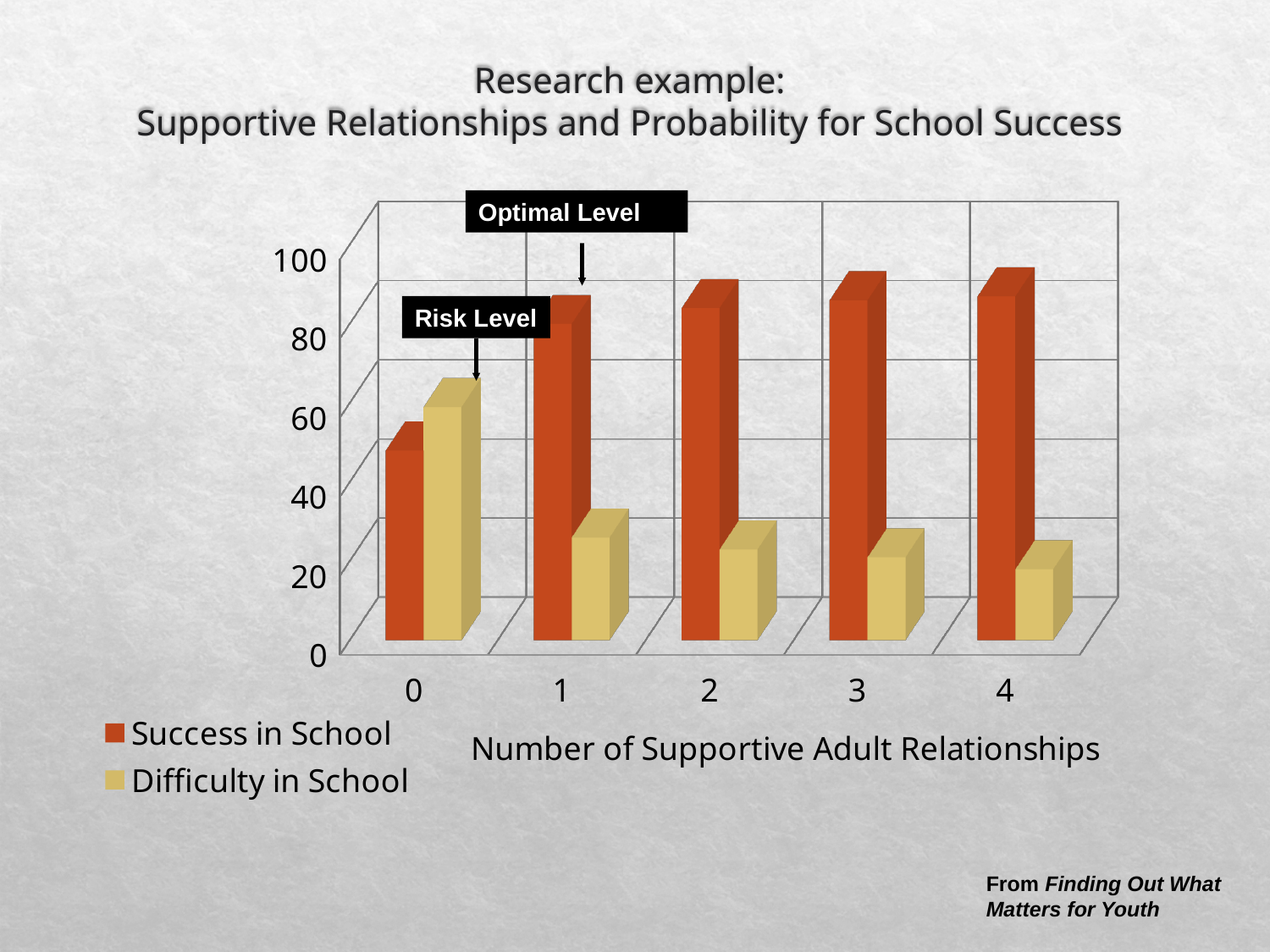
What kind of chart is shown on the slide? bar chart Is the value for Success in School at 0 supportive adult relationships greater or less than 60? less How many categories are shown along the x axis? 5 Which category has the lowest value for Success in School? 0 At 0 supportive adult relationships, which is larger: Success in School or Difficulty in School? Difficulty in School Is the value for Difficulty in School at 4 supportive adult relationships greater or less than 40? less Do the Difficulty in School values rise or fall as the number of supportive adult relationships increases? fall What is the title of the x axis? Number of Supportive Adult Relationships How many series does the legend list? 2 At 2 supportive adult relationships, which is larger: Success in School or Difficulty in School? Success in School Which category has the highest value for Difficulty in School? 0